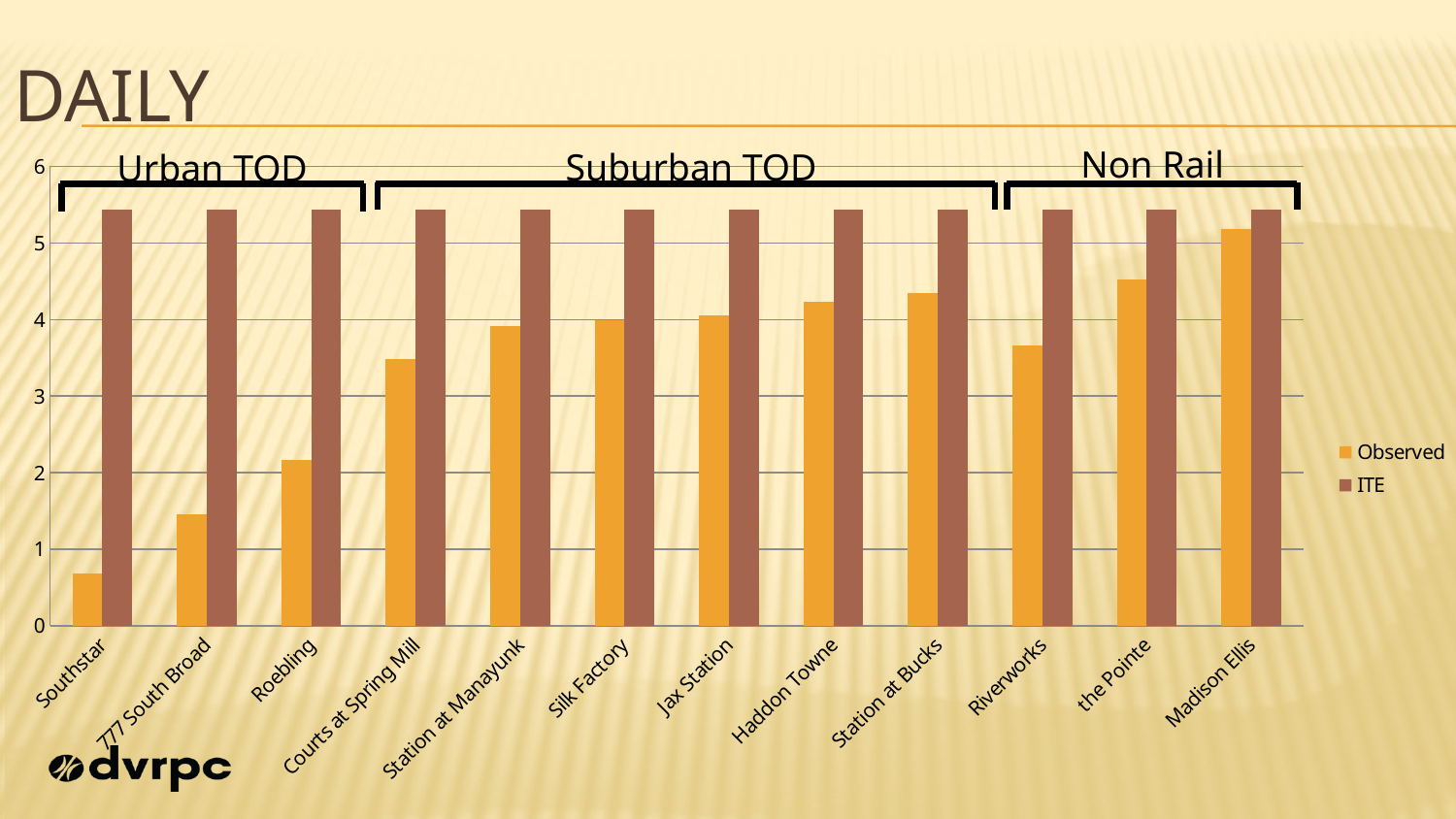
Is the Observed value for Courts at Spring Mill greater or less than 4? less Which site has the lowest Observed value? Southstar What are the three group labels shown above the bars? Urban TOD, Suburban TOD, Non Rail How many series does the legend list? 2 Which is larger, the Observed value for Roebling or the Observed value for 777 South Broad? Roebling Do the Observed values generally rise or fall moving from left to right along the x axis? rise Is the Observed value for Madison Ellis greater or less than 5? greater Which site has the highest Observed value? Madison Ellis What kind of chart is shown on the slide? bar chart Is the ITE value for Riverworks greater or less than 5? greater How many categories (sites) are shown along the x axis? 12